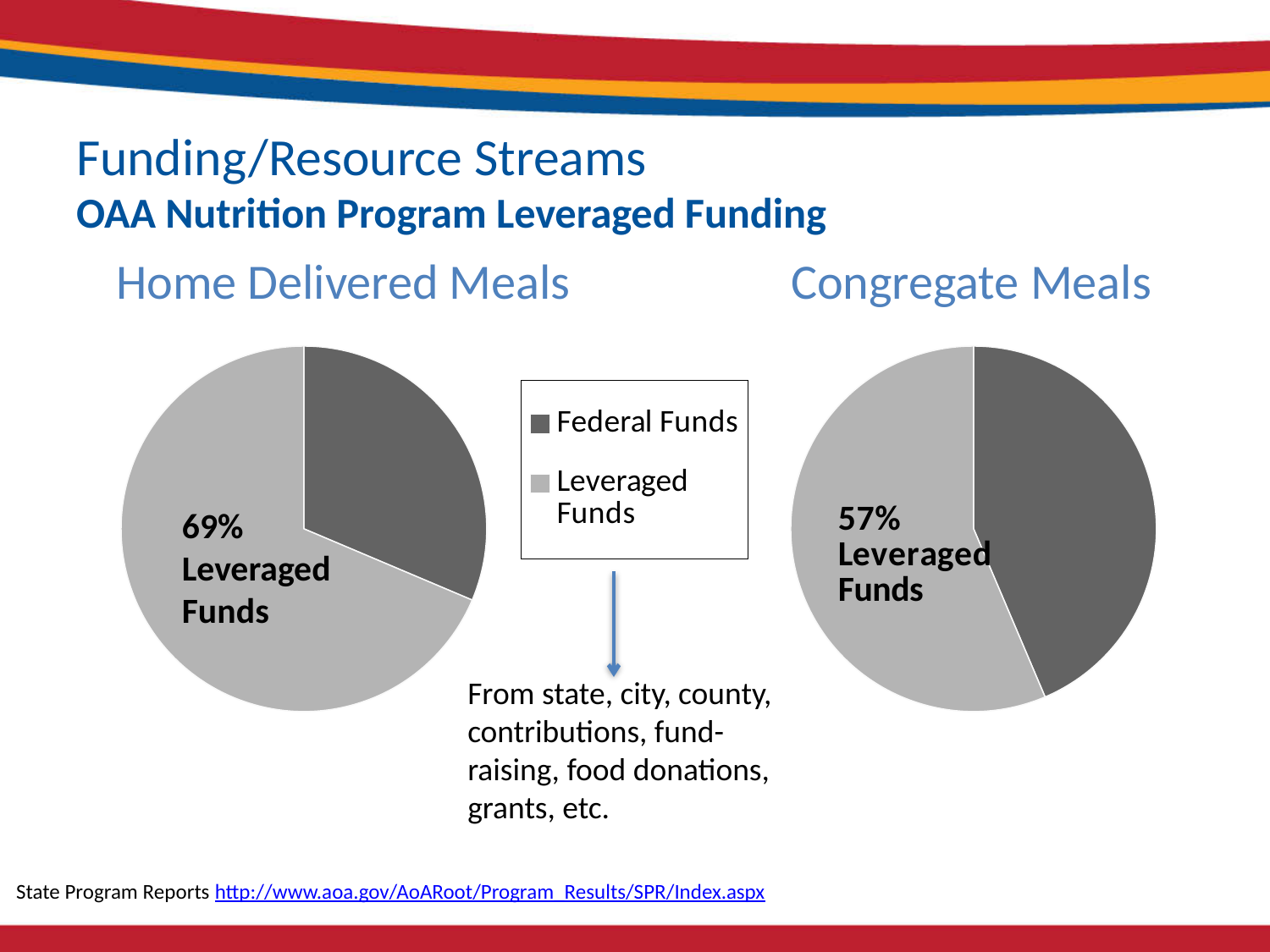
What type of chart is used for Home Delivered Meals? Pie chart Which colour represents Federal Funds in the pie charts? Dark grey What are the two entries in the legend? Federal Funds and Leveraged Funds In the Home Delivered Meals pie chart, what share of funding is Leveraged Funds? 69% What is the difference between the Leveraged Funds share for Home Delivered Meals and for Congregate Meals? 12% In the Home Delivered Meals pie chart, which slice is larger, Federal Funds or Leveraged Funds? Leveraged Funds How many series does the legend list? 2 Which pie chart shows the larger share of Leveraged Funds, Home Delivered Meals or Congregate Meals? Home Delivered Meals In the Congregate Meals pie chart, which slice is larger, Federal Funds or Leveraged Funds? Leveraged Funds What type of chart is used for Congregate Meals? Pie chart How many slices does each pie chart have? 2 In the Congregate Meals pie chart, what share of funding is Leveraged Funds? 57%